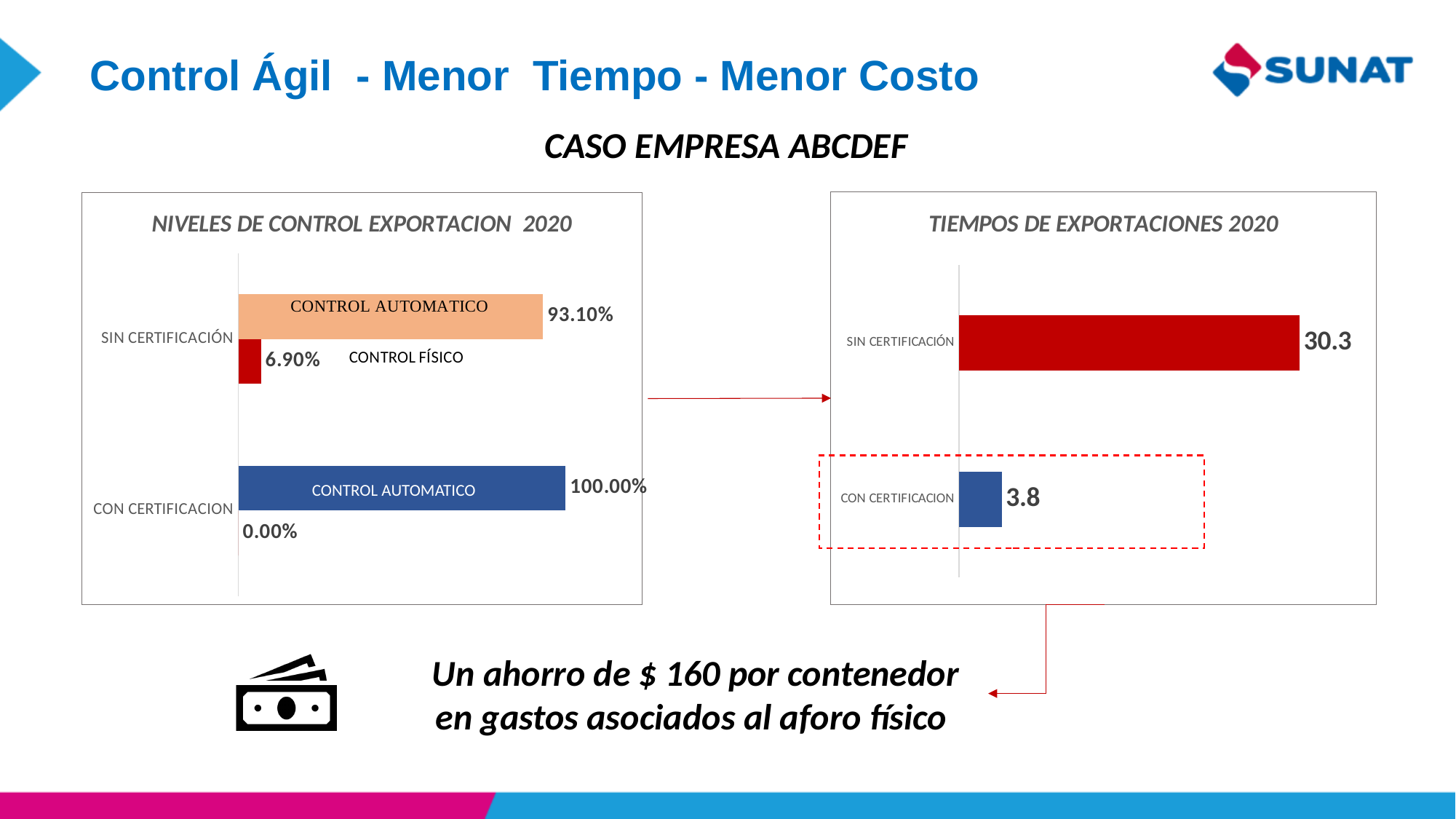
In the 'NIVELES DE CONTROL EXPORTACION 2020' chart, what is the CONTROL FÍSICO value for CON CERTIFICACION? 0.00% How many categories does the 'TIEMPOS DE EXPORTACIONES 2020' chart show? 2 What type of chart is 'TIEMPOS DE EXPORTACIONES 2020'? Bar chart In the 'NIVELES DE CONTROL EXPORTACION 2020' chart, what is the CONTROL AUTOMATICO value for SIN CERTIFICACIÓN? 93.10% In the 'TIEMPOS DE EXPORTACIONES 2020' chart, what is the value for CON CERTIFICACION? 3.8 In the 'TIEMPOS DE EXPORTACIONES 2020' chart, what is the difference between the SIN CERTIFICACIÓN and CON CERTIFICACION values? 26.5 In the 'TIEMPOS DE EXPORTACIONES 2020' chart, what is the value for SIN CERTIFICACIÓN? 30.3 In the 'NIVELES DE CONTROL EXPORTACION 2020' chart, what is the CONTROL AUTOMATICO value for CON CERTIFICACION? 100.00% In the 'TIEMPOS DE EXPORTACIONES 2020' chart, which category has the highest value? SIN CERTIFICACIÓN In the 'NIVELES DE CONTROL EXPORTACION 2020' chart, which is larger for SIN CERTIFICACIÓN: CONTROL AUTOMATICO or CONTROL FÍSICO? CONTROL AUTOMATICO In the 'NIVELES DE CONTROL EXPORTACION 2020' chart, what is the CONTROL FÍSICO value for SIN CERTIFICACIÓN? 6.90% In the 'NIVELES DE CONTROL EXPORTACION 2020' chart, what is the difference between the CONTROL AUTOMATICO and CONTROL FÍSICO values for SIN CERTIFICACIÓN? 86.20%